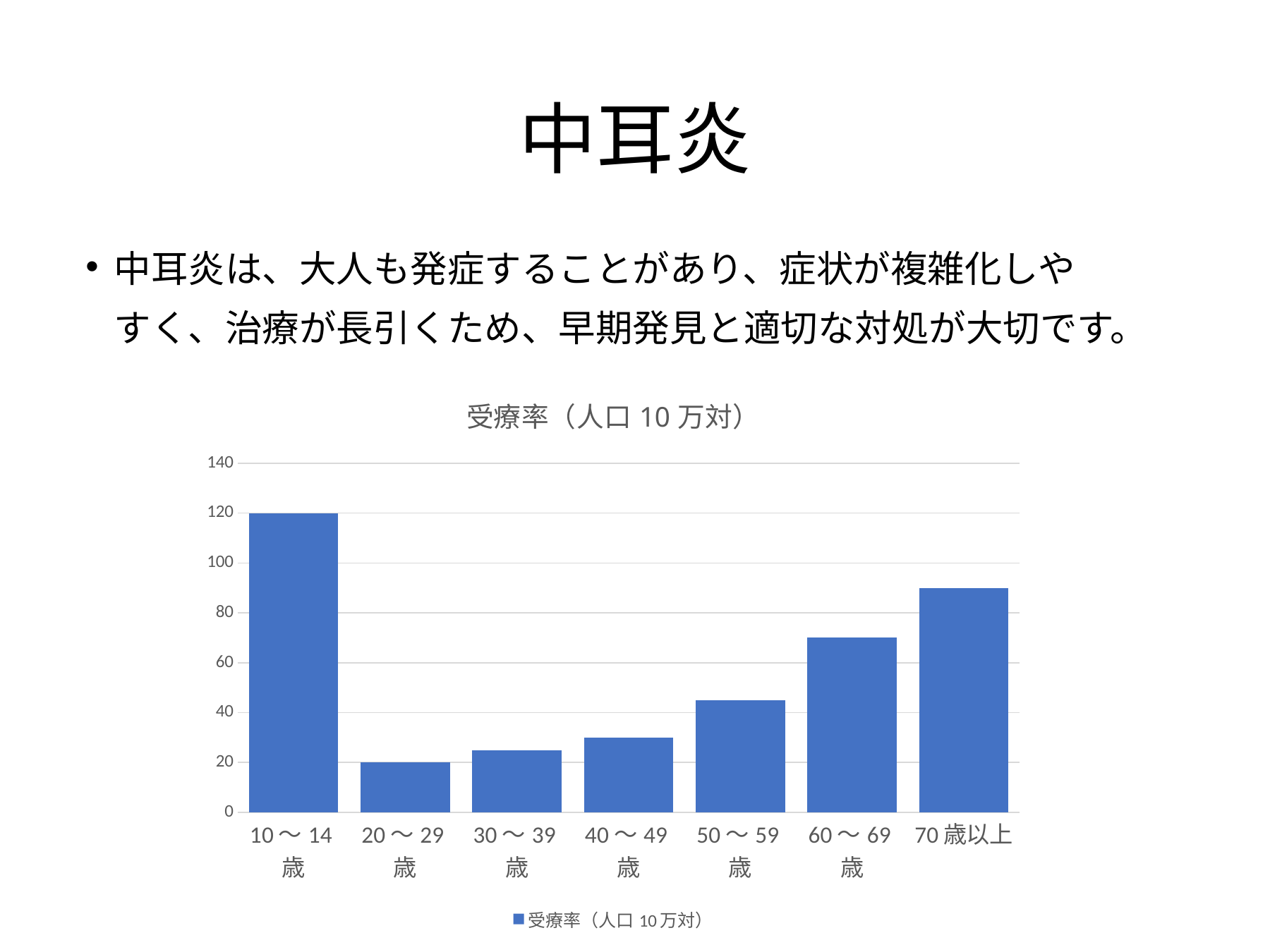
Which age category has the lowest value? 20〜29歳 What is the difference between the values for 10〜14歳 and 20〜29歳? 100 Is the value for 40〜49歳 greater or less than 40? less Which age category has the highest value? 10〜14歳 What type of chart is shown on the slide? bar chart Which is larger, the value for 70歳以上 or the value for 60〜69歳? 70歳以上 Is the value for 70歳以上 greater or less than 80? greater What is the title of the chart? 受療率（人口 10 万対） How many series does the legend list? 1 How many age categories are shown on the x axis? 7 What is the value for 20〜29歳? 20 What is the value for 10〜14歳? 120